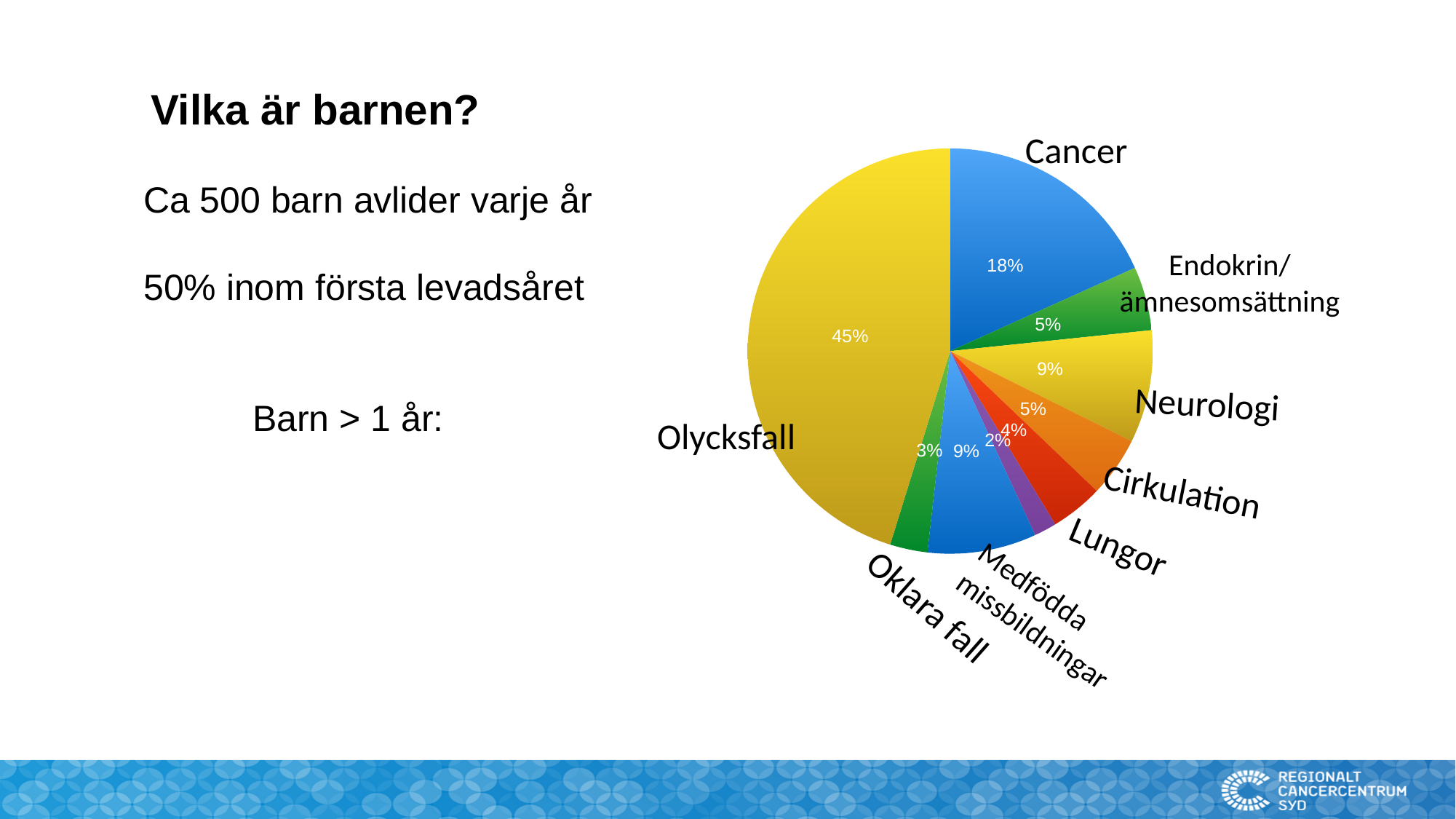
What kind of chart is shown on the slide? pie chart What percentage is shown for Neurologi? 9% How many percentage points larger is Olycksfall than Cancer? 27 Which category has the largest slice of the pie? Olycksfall What percentage is shown for Lungor? 4% Which is larger, the slice for Cancer or the slice for Neurologi? Cancer What colour is the Olycksfall slice? yellow What percentage is shown for Cirkulation? 5% What percentage is shown for Cancer? 18% What percentage is shown for Endokrin/ämnesomsättning? 5% What share of the pie does Olycksfall account for? 45% How many slices does the pie chart have? 9